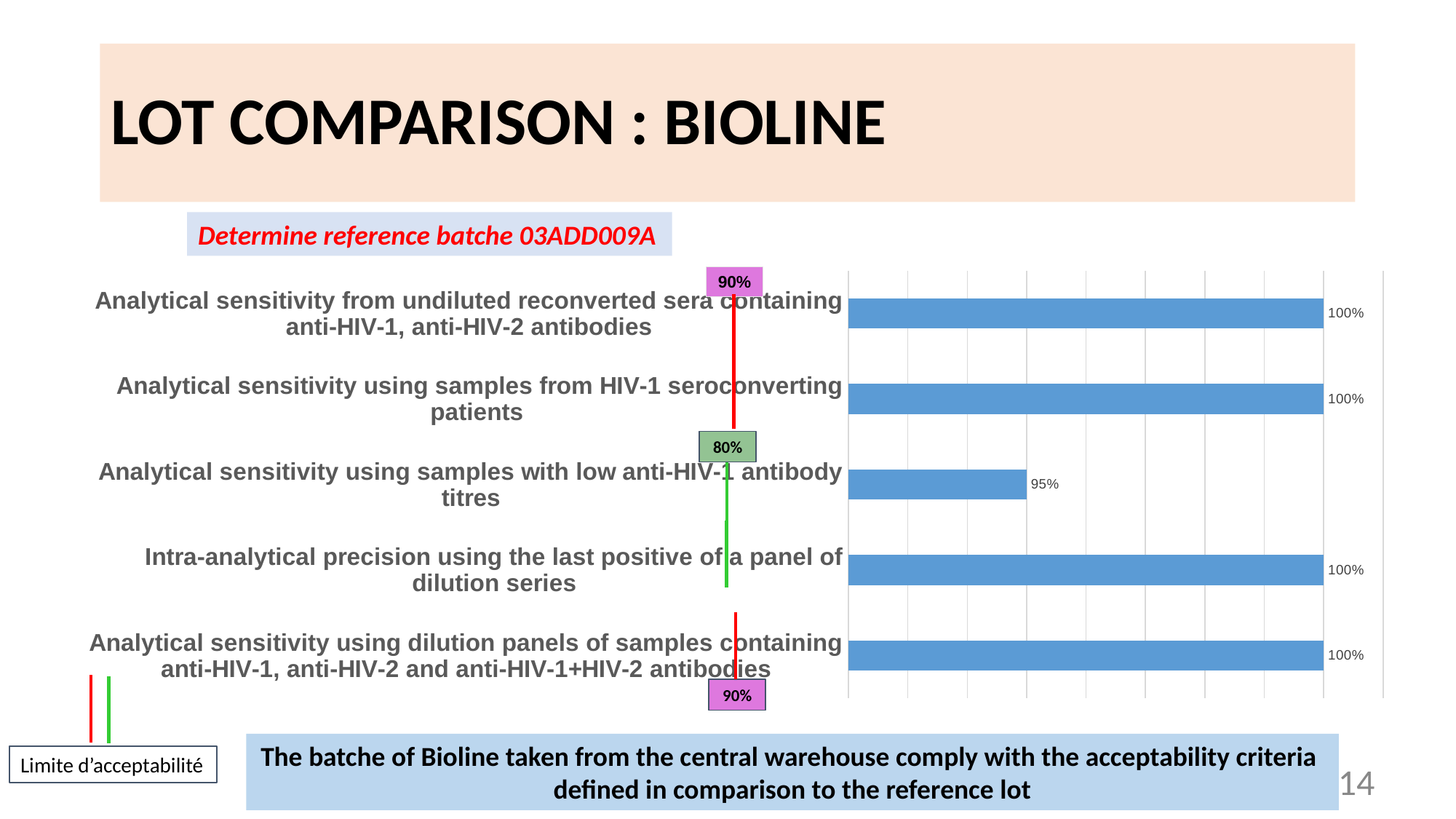
How many categories are plotted in the bar chart? 5 What colour are the bars in the chart? blue Which is larger: the value for 'Intra-analytical precision using the last positive of a panel of dilution series' or the value for 'Analytical sensitivity using samples with low anti-HIV-1 antibody titres'? Intra-analytical precision using the last positive of a panel of dilution series What is the value for 'Analytical sensitivity using dilution panels of samples containing anti-HIV-1, anti-HIV-2 and anti-HIV-1+HIV-2 antibodies'? 100% What is the value for 'Analytical sensitivity from undiluted reconverted sera containing anti-HIV-1, anti-HIV-2 antibodies'? 100% What kind of chart is shown on the slide? bar chart What is the value for 'Analytical sensitivity using samples from HIV-1 seroconverting patients'? 100% Which category has the lowest value in the bar chart? Analytical sensitivity using samples with low anti-HIV-1 antibody titres What is the value for 'Intra-analytical precision using the last positive of a panel of dilution series'? 100% What is the difference between the value for 'Analytical sensitivity using samples from HIV-1 seroconverting patients' and the value for 'Analytical sensitivity using samples with low anti-HIV-1 antibody titres'? 5% How many categories in the bar chart have a value of 100%? 4 What is the value for 'Analytical sensitivity using samples with low anti-HIV-1 antibody titres'? 95%